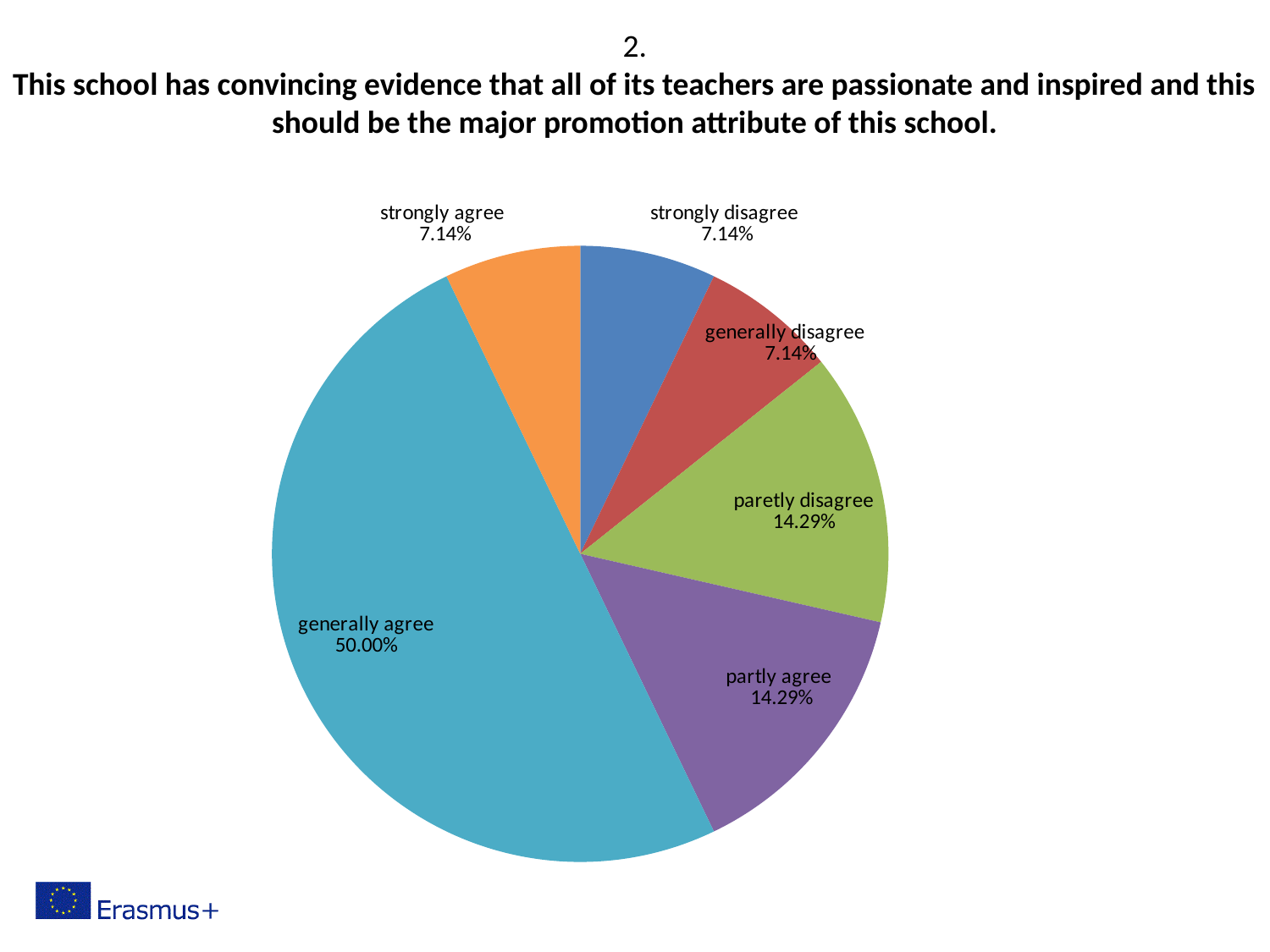
What share of the pie does "generally agree" take? 50.00% What is the difference between the values for "generally agree" and "partly agree"? 35.71% What is the combined value of "strongly disagree" and "generally disagree"? 14.28% What is the value shown for "paretly disagree"? 14.29% What colour is the "generally agree" slice? light blue How many slices does the pie chart have? 6 Which category has the largest slice of the pie? generally agree What is the value shown for "strongly agree"? 7.14% Which is larger, the value for "paretly disagree" or the value for "generally disagree"? paretly disagree What kind of chart is shown on the slide? pie chart What is the value shown for "partly agree"? 14.29% What is the value shown for "strongly disagree"? 7.14%